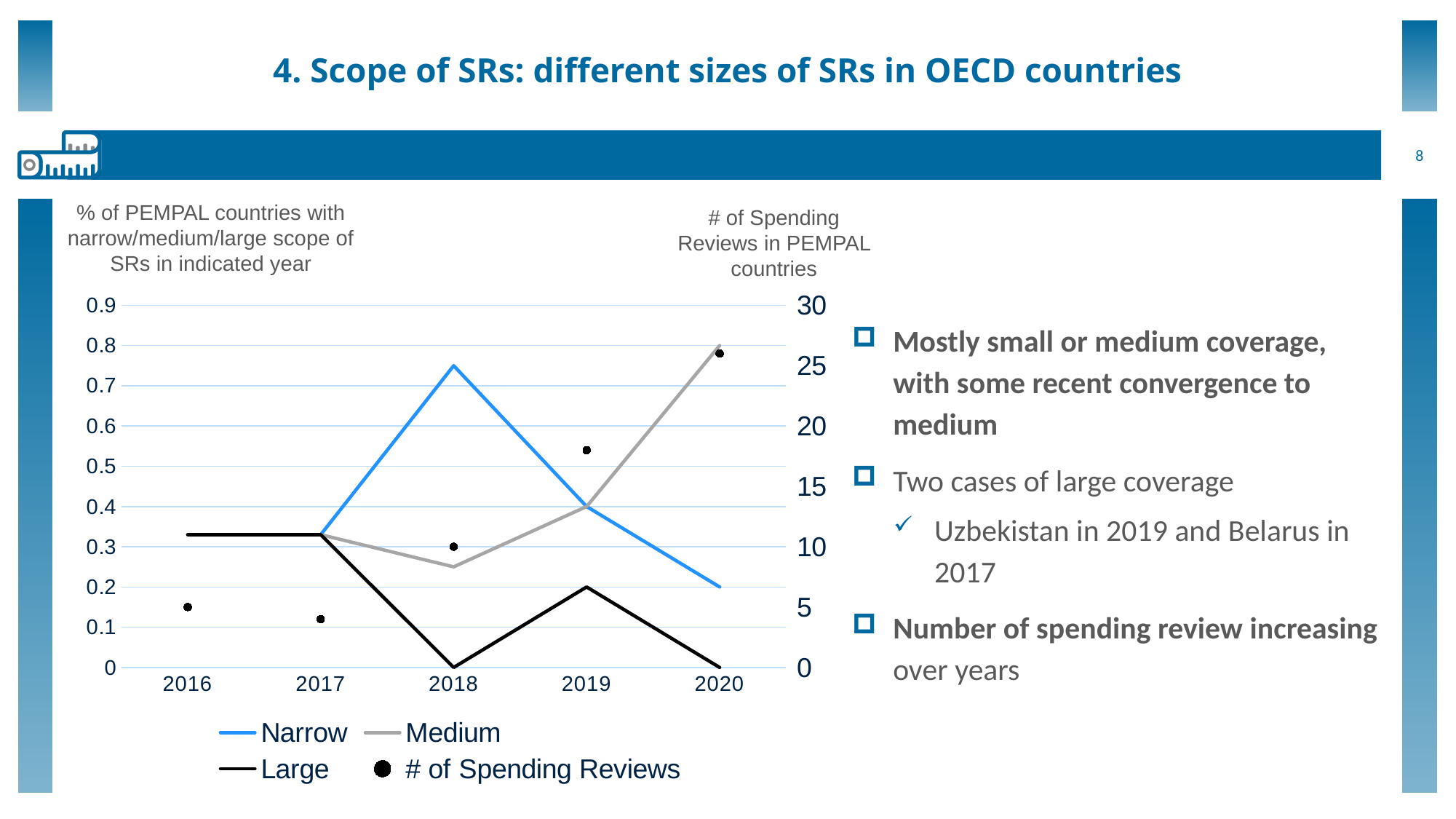
What is the value of the Medium series in 2020? 0.8 What is the value of the Narrow series in 2020? 0.2 How many series does the legend list? 4 What kind of chart is shown on the slide? line chart What is the # of Spending Reviews in 2018? 10 What is the value of the Large series in 2018? 0 Is the Narrow value in 2018 greater or less than 0.7? greater Is the # of Spending Reviews in 2020 greater or less than 25? greater In 2018, which is larger, the Narrow series or the Medium series? Narrow In which year is the Narrow series at its highest? 2018 How many years are shown on the x axis? 5 Does the # of Spending Reviews generally rise or fall from 2017 to 2020? rise